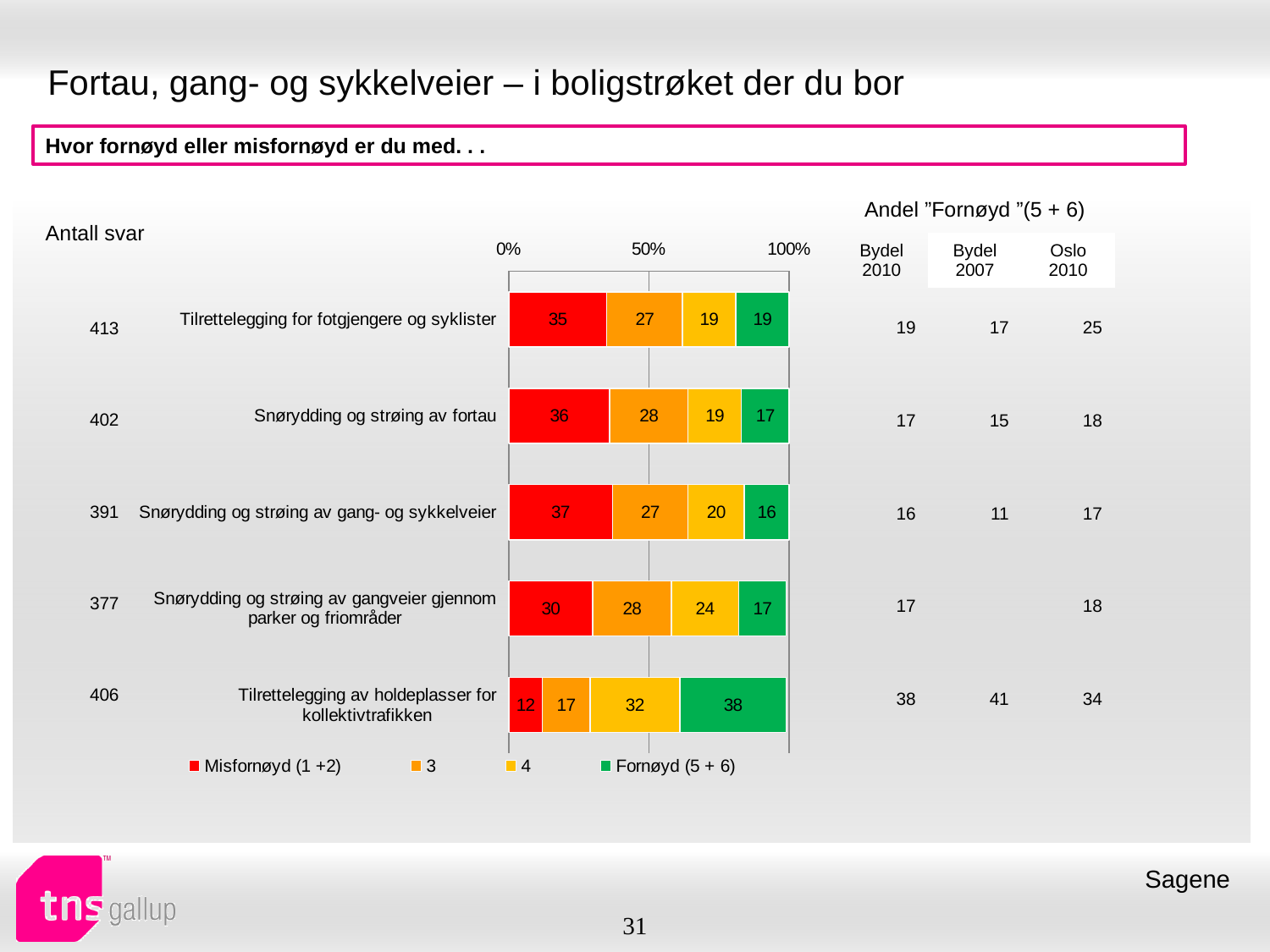
Which is larger: the Fornøyd (5 + 6) value for "Tilrettelegging for fotgjengere og syklister" or for "Snørydding og strøing av gang- og sykkelveier"? Tilrettelegging for fotgjengere og syklister What colour represents the Fornøyd (5 + 6) series in the chart? Green How many categories (statements) are plotted in the chart? 5 What is the difference between the Misfornøyd (1 +2) values for "Snørydding og strøing av fortau" and "Tilrettelegging av holdeplasser for kollektivtrafikken"? 24 How many series does the chart legend list? 4 What kind of chart is shown on the slide? Stacked bar chart What is the total of the stacked bar for "Snørydding og strøing av fortau"? 100 What is the Misfornøyd (1 +2) value for "Snørydding og strøing av gang- og sykkelveier"? 37 Which category has the lowest Misfornøyd (1 +2) value? Tilrettelegging av holdeplasser for kollektivtrafikken Which category has the highest Fornøyd (5 + 6) value? Tilrettelegging av holdeplasser for kollektivtrafikken What is the value of the "4" segment for "Snørydding og strøing av gangveier gjennom parker og friområder"? 24 What is the Fornøyd (5 + 6) value for "Tilrettelegging av holdeplasser for kollektivtrafikken"? 38